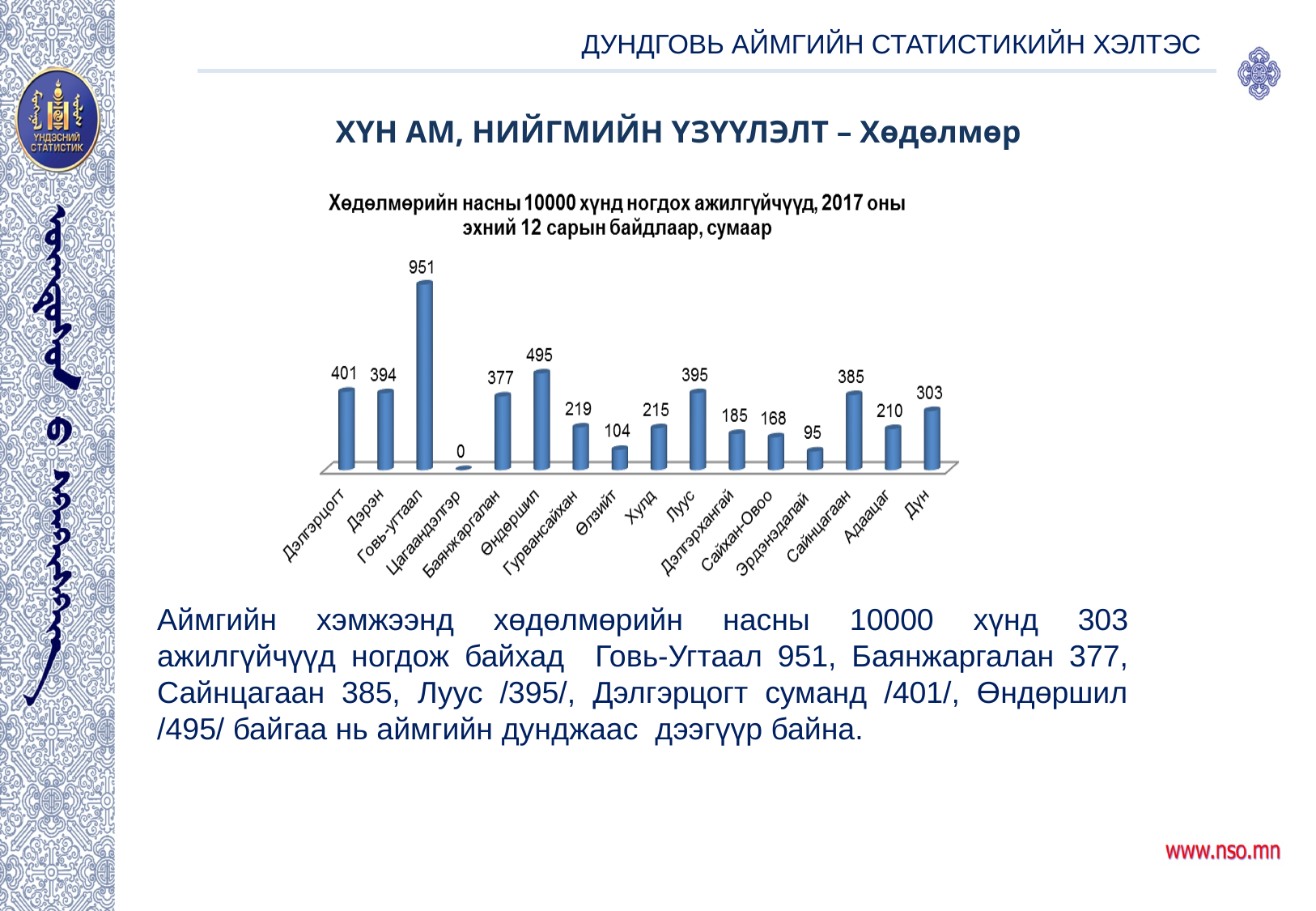
What is the value for Дүн? 303 Which category has the lowest value? Цагаандэлгэр What is the value for Эрдэнэдалай? 95 Which is larger, the value for Луус or the value for Дэрэн? Луус What is the difference between the values for Сайнцагаан and Адаацаг? 175 What is the value for Өндөршил? 495 Which is larger, the value for Хулд or the value for Өлзийт? Хулд What kind of chart is shown on the slide? Bar chart What is the difference between the values for Говь-Угтаал and Өндөршил? 456 What is the value for Говь-Угтаал? 951 How many categories are shown on the x axis? 16 Which category has the highest value? Говь-Угтаал